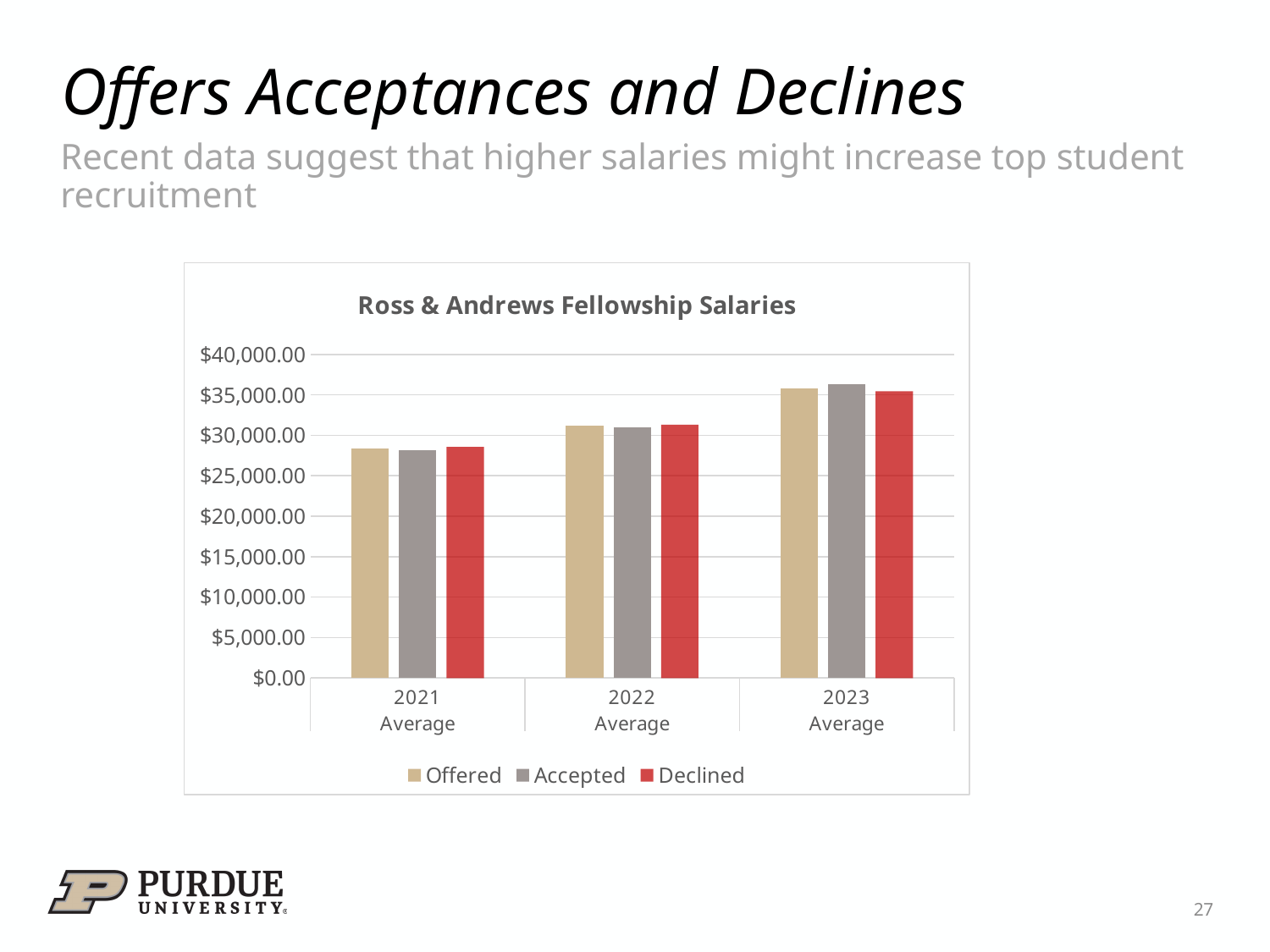
Is the Declined value for 2022 Average greater or less than $35,000.00? less Which year has the lowest Declined value? 2021 Average Is the Accepted value for 2023 Average greater or less than $35,000.00? greater Which series is shown in red? Declined Is the Offered value for 2021 Average greater or less than $30,000.00? less How many series does the legend list? 3 Which year has the highest Offered value? 2023 Average Do the Accepted values rise or fall from 2021 to 2023? Rise What is the title of the chart? Ross & Andrews Fellowship Salaries What kind of chart is shown on the slide? Bar chart How many year categories are shown on the x axis? 3